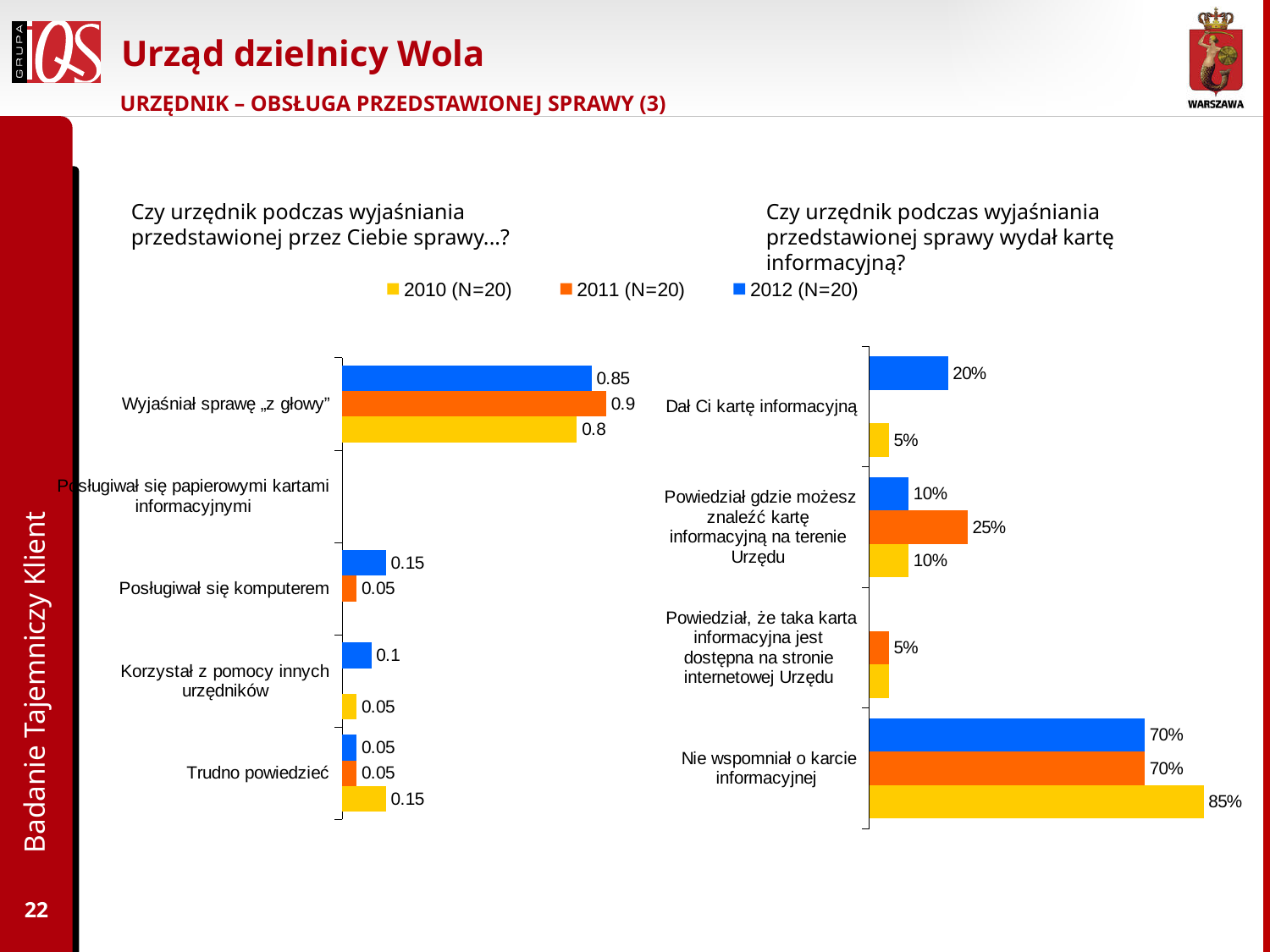
In the left chart, what is the 2012 (N=20) value for "Posługiwał się komputerem"? 0.15 In the right chart, what is the 2010 (N=20) value for "Nie wspomniał o karcie informacyjnej"? 85% How many series does the legend list? 3 In the right chart, what is the difference between the 2010 and 2012 values for "Nie wspomniał o karcie informacyjnej"? 15% In the left chart, what is the 2010 (N=20) value for "Trudno powiedzieć"? 0.15 In the left chart, what is the 2011 (N=20) value for "Wyjaśniał sprawę „z głowy""? 0.9 In the right chart, which is larger for "Dał Ci kartę informacyjną": the 2012 value or the 2010 value? 2012 In the right chart, what is the 2012 (N=20) value for "Dał Ci kartę informacyjną"? 20% In the left chart, what is the difference between the 2011 and 2010 values for "Wyjaśniał sprawę „z głowy""? 0.1 In the left chart, which category has the highest 2012 (N=20) value? Wyjaśniał sprawę „z głowy" In the right chart, what is the 2011 (N=20) value for "Powiedział gdzie możesz znaleźć kartę informacyjną na terenie Urzędu"? 25% What kind of chart is the right chart? Bar chart